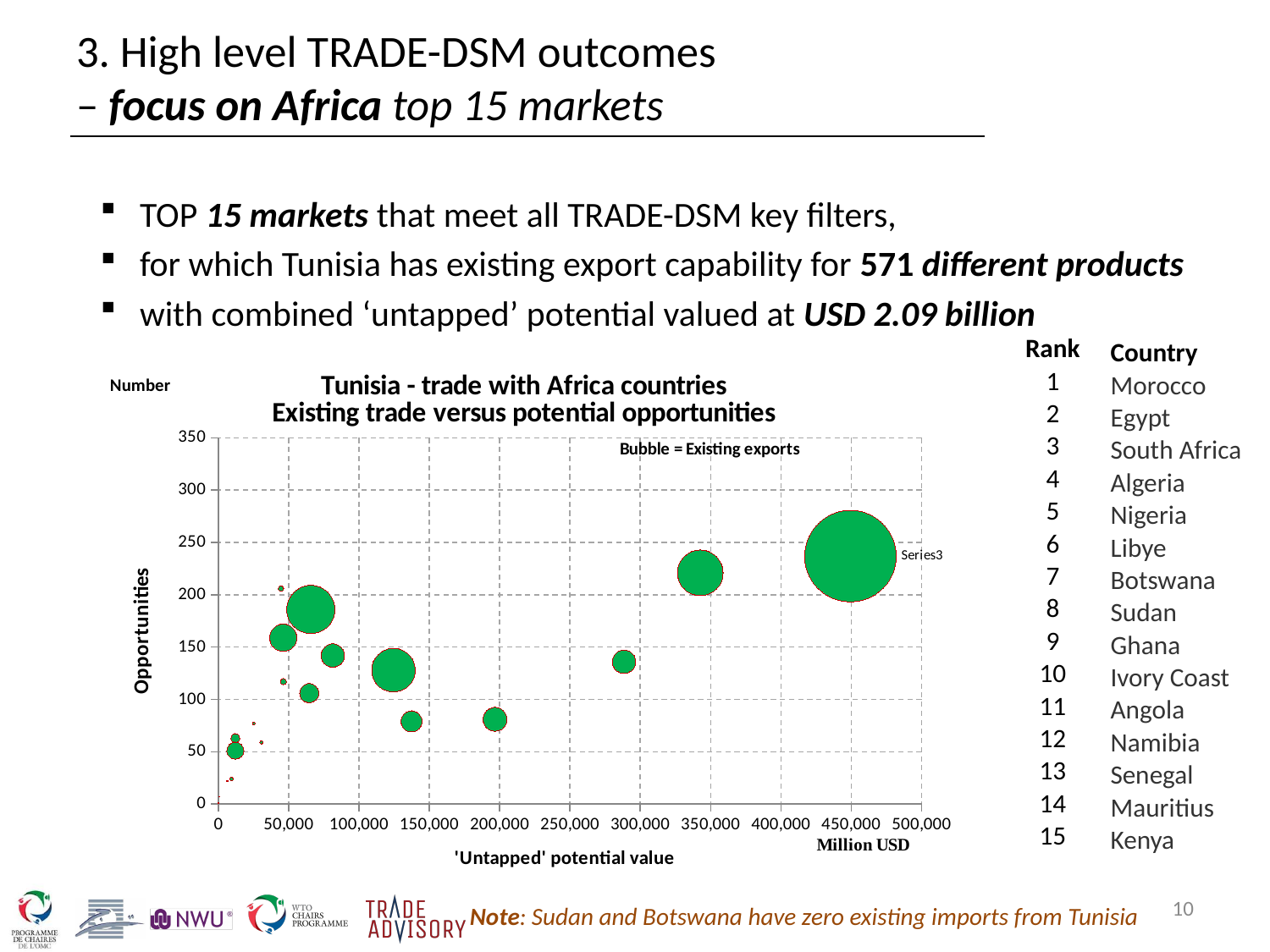
What kind of chart is shown on the slide? bubble chart Is the 'untapped' potential value of the bubble furthest to the right greater or less than 500,000? less What is the title of the chart? Tunisia - trade with Africa countries Existing trade versus potential opportunities Is the 'untapped' potential value of the largest bubble greater or less than 400,000? greater What is the highest tick value shown on the y axis of the chart? 350 Is the opportunities value of the largest bubble greater or less than 300? less What is the highest tick value shown on the x axis of the chart? 500,000 Which bubble has the higher opportunities value: the largest bubble or the bubble located near 350,000 on the x axis? the largest bubble